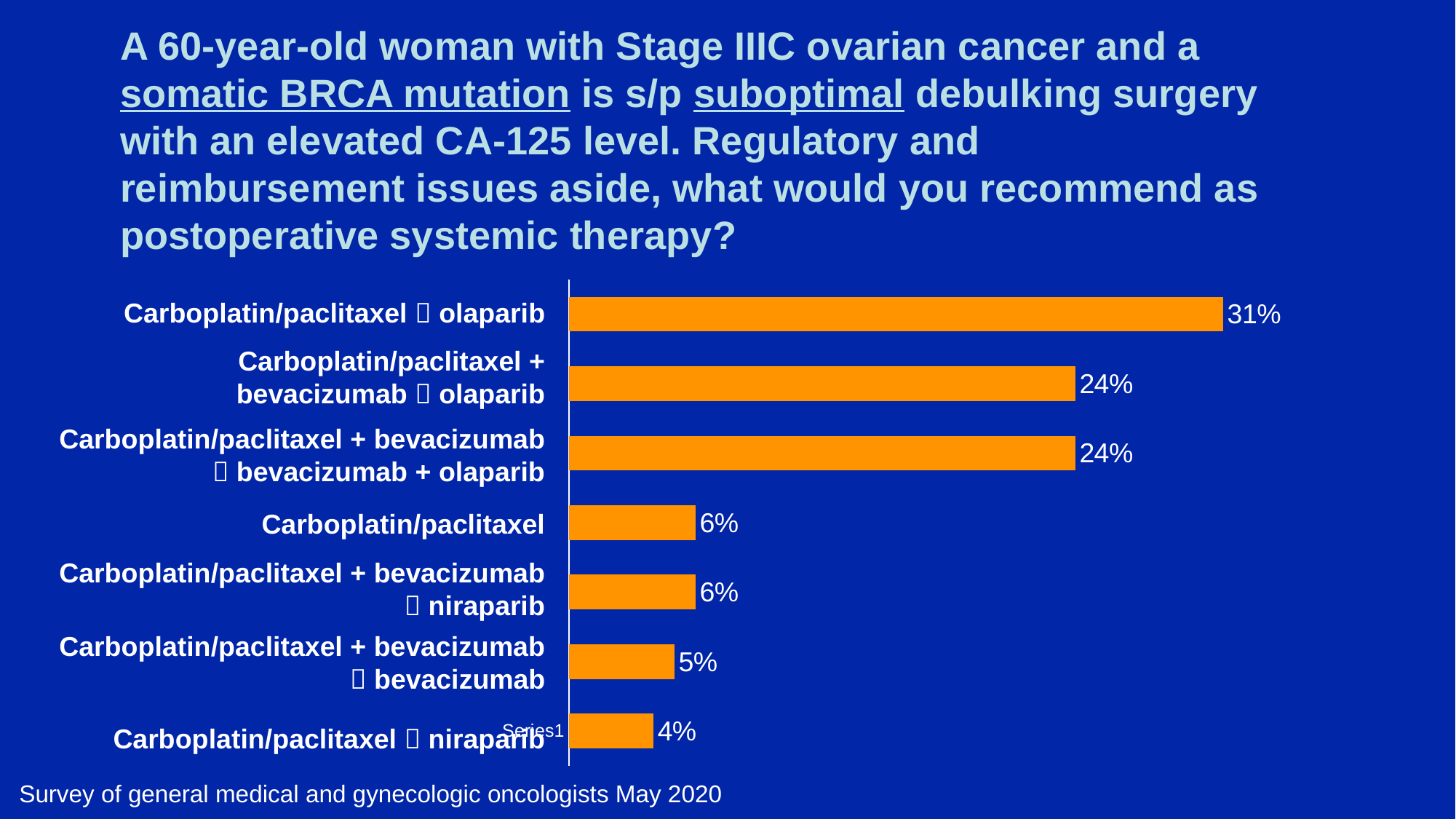
What colour are the bars in the chart? Orange Which option received the highest percentage of responses? Carboplatin/paclitaxel → olaparib Which received a larger share of responses: Carboplatin/paclitaxel + bevacizumab → bevacizumab or Carboplatin/paclitaxel → niraparib? Carboplatin/paclitaxel + bevacizumab → bevacizumab How many treatment options are shown in the chart? 7 Which option received the lowest percentage of responses? Carboplatin/paclitaxel → niraparib How many percentage points higher is Carboplatin/paclitaxel → olaparib than Carboplatin/paclitaxel + bevacizumab → olaparib? 7 percentage points What percentage of respondents chose Carboplatin/paclitaxel alone? 6% What percentage of respondents chose Carboplatin/paclitaxel → niraparib? 4% What type of chart is shown on the slide? Bar chart What percentage of respondents chose Carboplatin/paclitaxel → olaparib? 31% What is the difference between the percentages for Carboplatin/paclitaxel alone and Carboplatin/paclitaxel → niraparib? 2 percentage points What percentage of respondents chose Carboplatin/paclitaxel + bevacizumab → niraparib? 6%